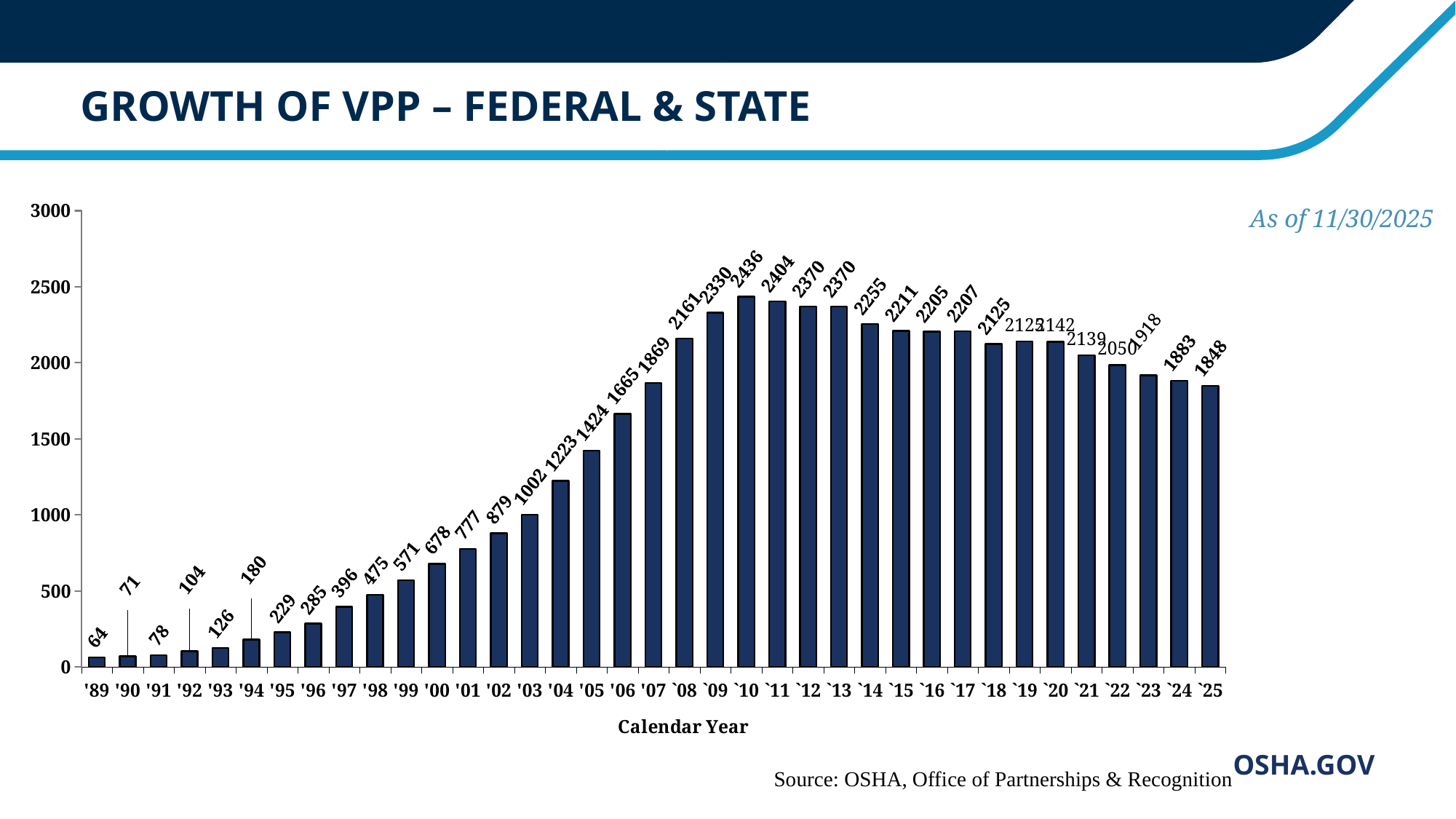
What is the difference between the values for '10 and '09? 106 Which year has the lowest value? '89 How many years are shown on the x axis? 37 What is the difference between the values for '24 and '25? 35 What is the value for '89? 64 Which year has the highest value? '10 Which is larger, the value for '05 or the value for '06? '06 What is the value for '03? 1002 What kind of chart is this? Bar chart What is the value for '25? 1848 Do the values rise or fall from '89 to '10? Rise What is the value for '10? 2436